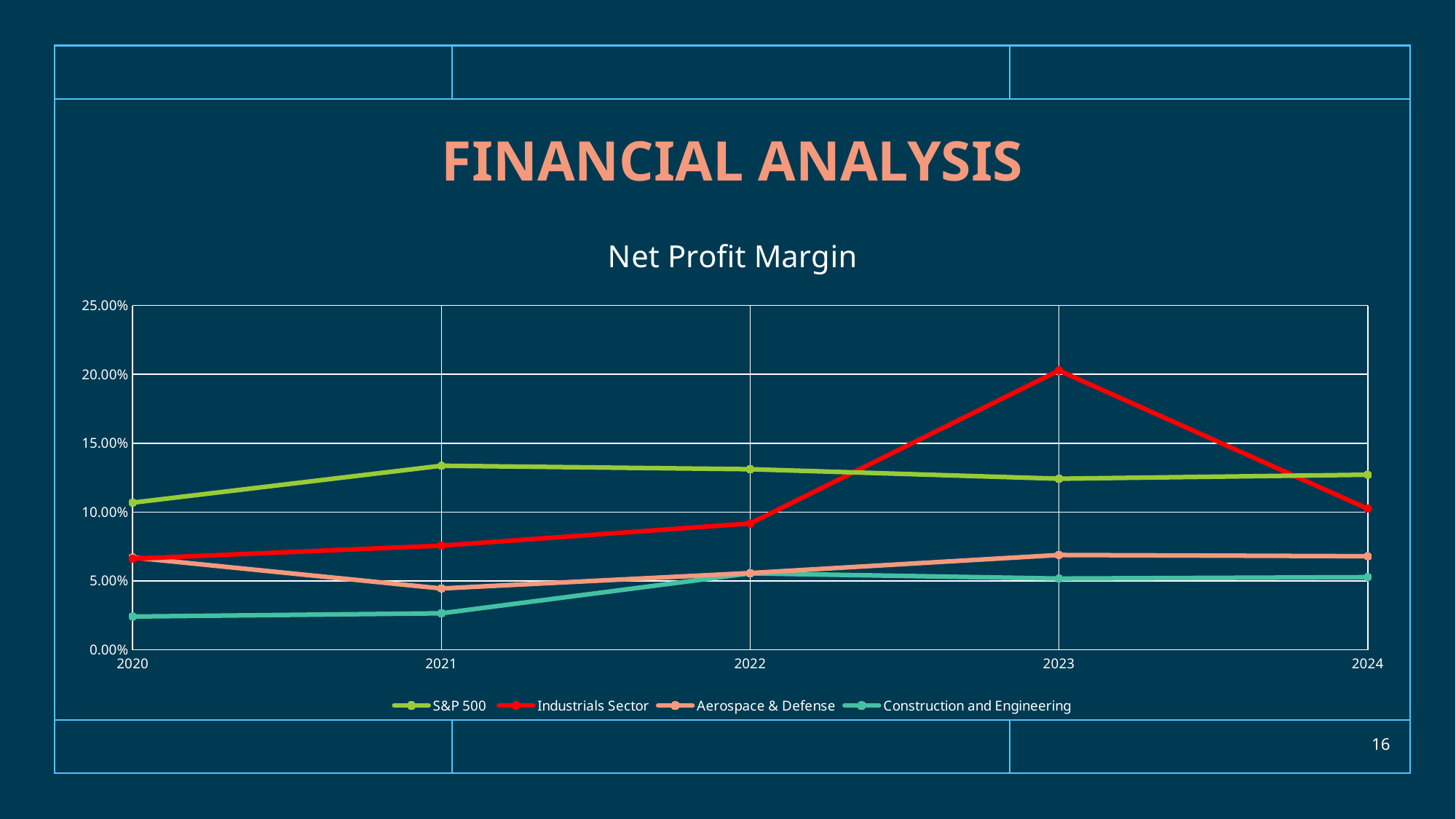
How many years are shown on the x axis? 5 What kind of chart is shown on the slide? Line chart What is the title of the chart? Net Profit Margin In which year does the Industrials Sector reach its highest net profit margin? 2023 Is the value for Industrials Sector in 2023 greater or less than 15.00%? greater Does the Industrials Sector line rise or fall from 2023 to 2024? fall Which series has the highest net profit margin in 2023? Industrials Sector Is the value for Construction and Engineering in 2020 greater or less than 5.00%? less In 2024, which is higher: S&P 500 or Industrials Sector? S&P 500 Which series has the lowest net profit margin in 2020? Construction and Engineering How many series does the legend list? 4 Is the value for S&P 500 in 2021 greater or less than 15.00%? less